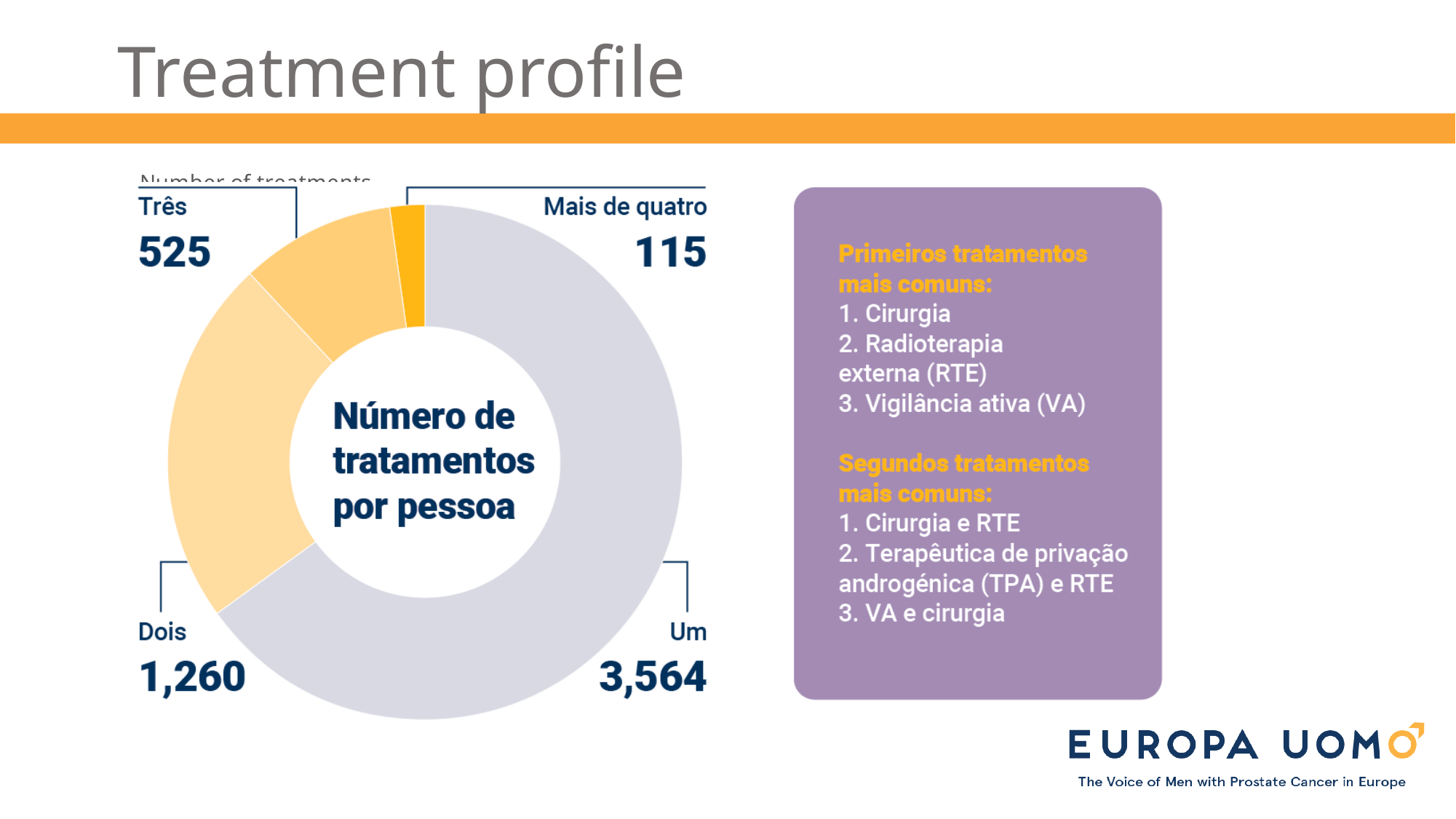
Which category has the highest value in the donut chart? Um Which is larger, the value for "Dois" or the value for "Três"? Dois What is the difference between the values for "Três" and "Mais de quatro"? 410 What is the value for the "Dois" category in the donut chart? 1,260 Which category has the lowest value in the donut chart? Mais de quatro What text is written in the centre of the donut chart? Número de tratamentos por pessoa What is the value for the "Três" category in the donut chart? 525 What kind of chart is shown on the slide? Donut (pie) chart What is the value for the "Mais de quatro" category in the donut chart? 115 What is the difference between the values for "Um" and "Dois"? 2,304 How many categories are shown in the donut chart? 4 What is the value for the "Um" category in the donut chart? 3,564